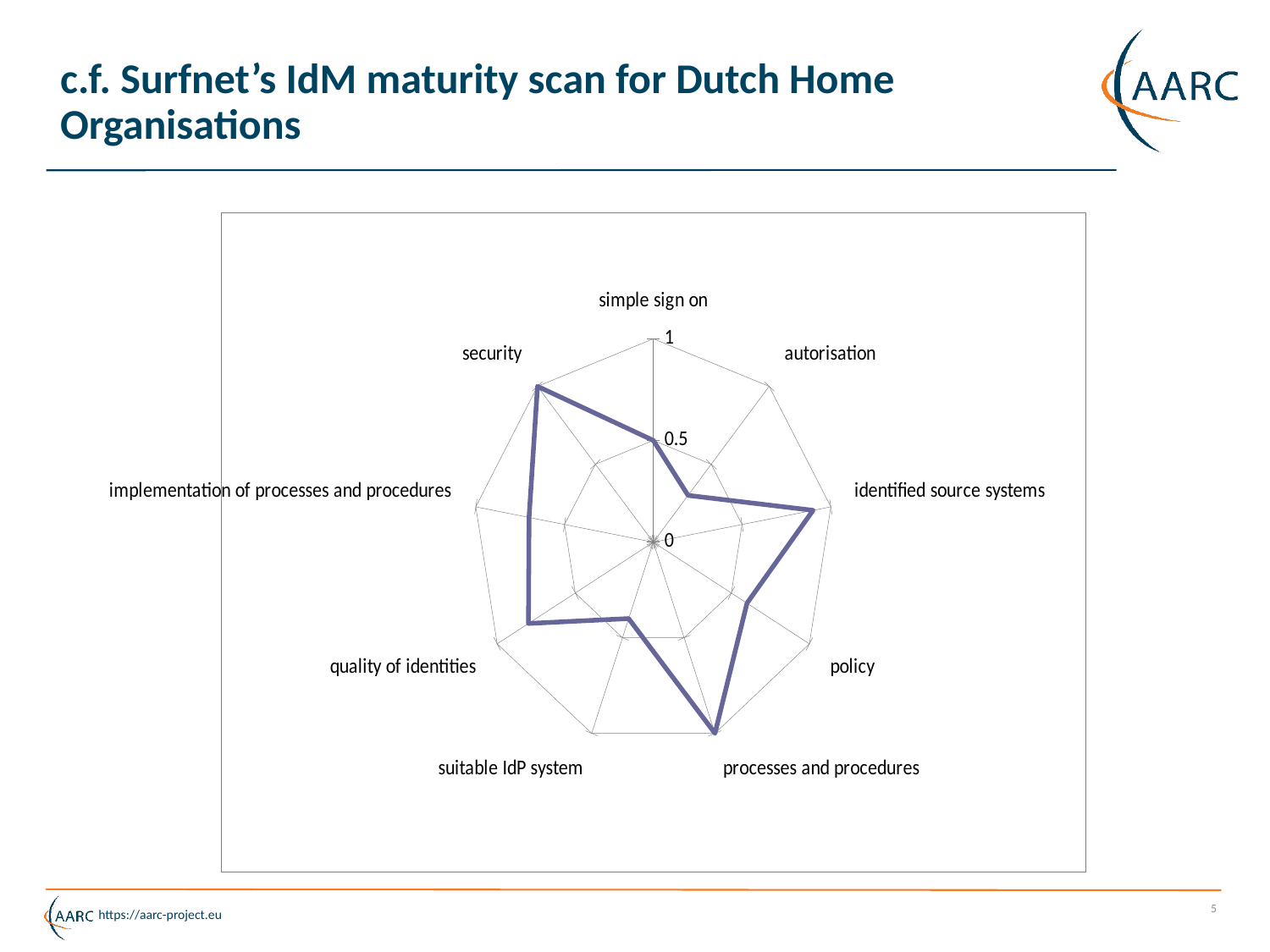
Is the value for autorisation greater or less than 0.5? less Is the value for processes and procedures greater or less than 0.5? greater How many categories (axes) does the radar chart have? 9 Which category has the lowest value on the radar chart? autorisation Is the value for quality of identities greater or less than 0.5? greater What kind of chart is shown on the slide? radar chart What is the title of the slide containing the radar chart? c.f. Surfnet's IdM maturity scan for Dutch Home Organisations Which has the larger value, identified source systems or suitable IdP system? identified source systems Which has the larger value, security or autorisation? security What is the maximum value shown on the radar chart's axis scale? 1